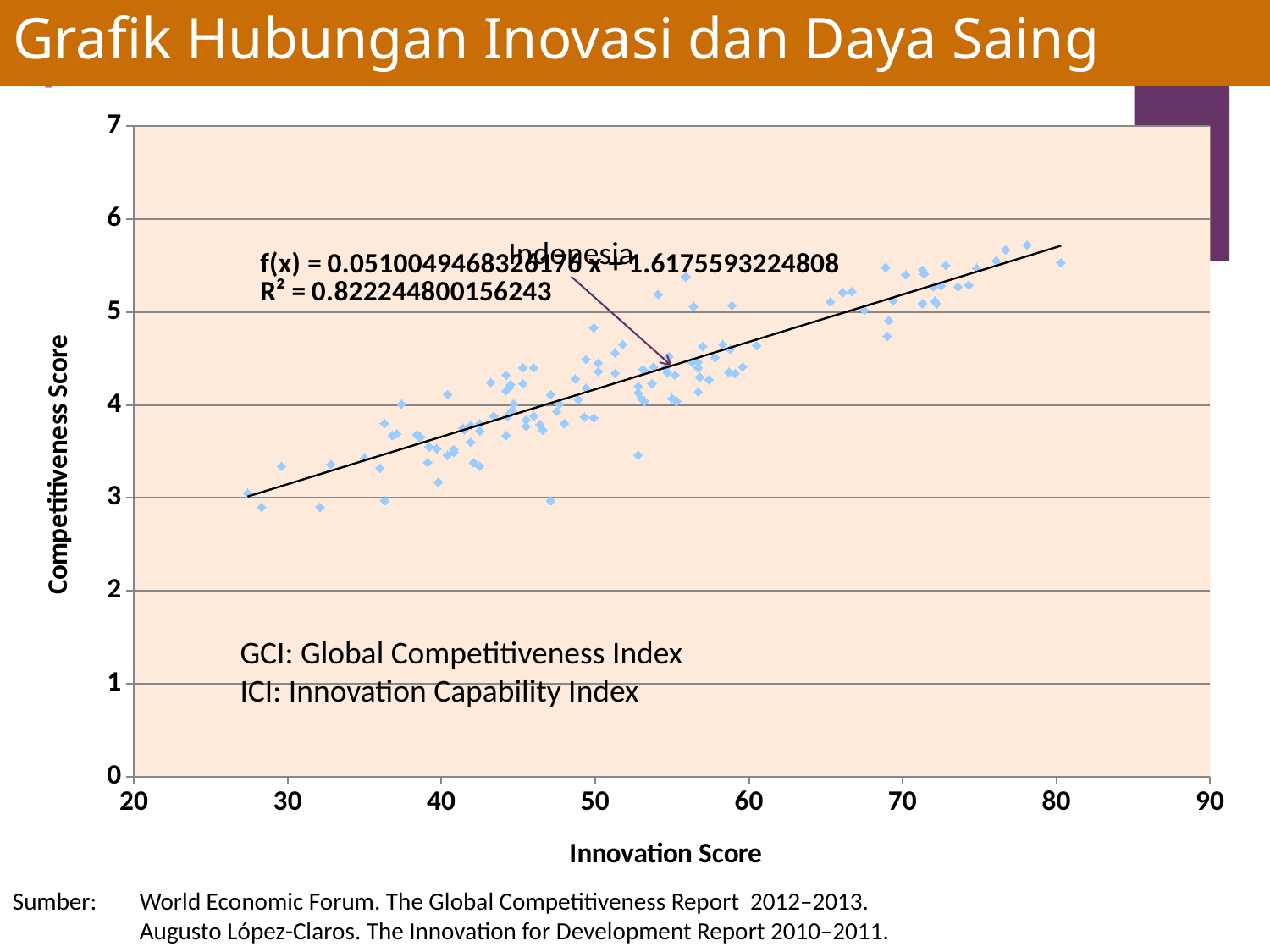
Is the Competitiveness Score of the lowest plotted point greater or less than 3? less Is the Competitiveness Score for the point labelled Indonesia greater or less than 5? less What is the highest value shown on the x axis? 90 Is the Competitiveness Score for the point labelled Indonesia greater or less than 4? greater What is the trend line equation printed on the chart? f(x) = 0.0510049468326176 x + 1.6175593224808 Do the Competitiveness Score values generally rise or fall as the Innovation Score increases? rise What is the R² value printed on the chart? R² = 0.822244800156243 What is the label of the x axis? Innovation Score What is the highest value shown on the y axis? 7 Which country is labelled with an arrow on the chart? Indonesia What kind of chart is shown on the slide? scatter chart